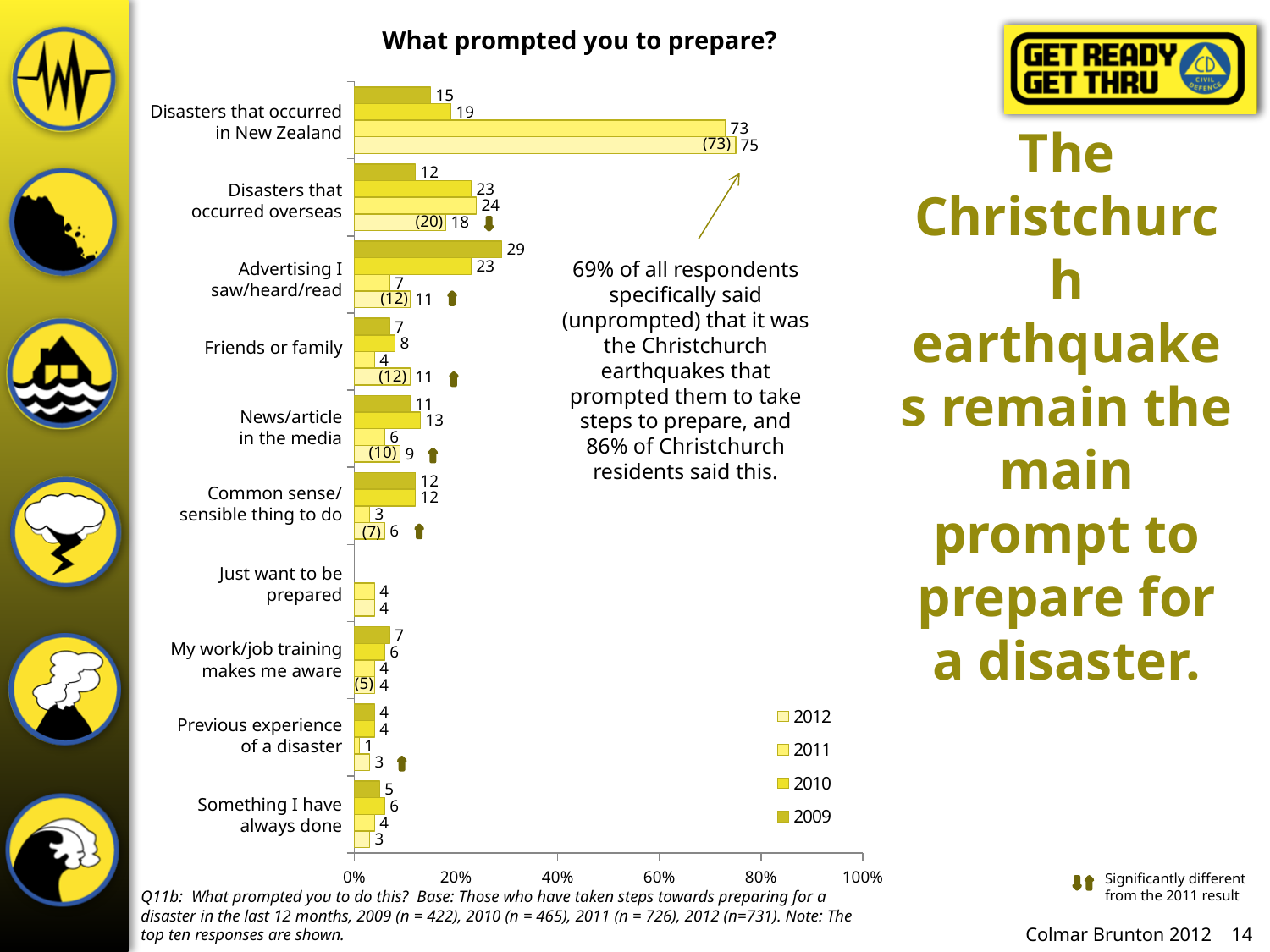
How many series does the chart legend list? 4 Which category has the longest bar on the chart? Disasters that occurred in New Zealand What is the title of the chart? What prompted you to prepare? What is the 2012 value for 'Disasters that occurred in New Zealand'? 75 What kind of chart is shown on the slide? Bar chart How many response categories are shown on the chart? 10 What is the 2012 value for 'Something I have always done'? 3 Which years are listed in the chart legend? 2012, 2011, 2010, 2009 What is the difference between the 2009 value (29) and the 2010 value (23) for 'Advertising I saw/heard/read'? 6 Which is larger: the 2009 value for 'Advertising I saw/heard/read' or the 2009 value for 'Disasters that occurred overseas'? Advertising I saw/heard/read What is the 2009 value for 'Advertising I saw/heard/read'? 29 Is the 2012 value for 'Disasters that occurred in New Zealand' greater or less than 60%? greater